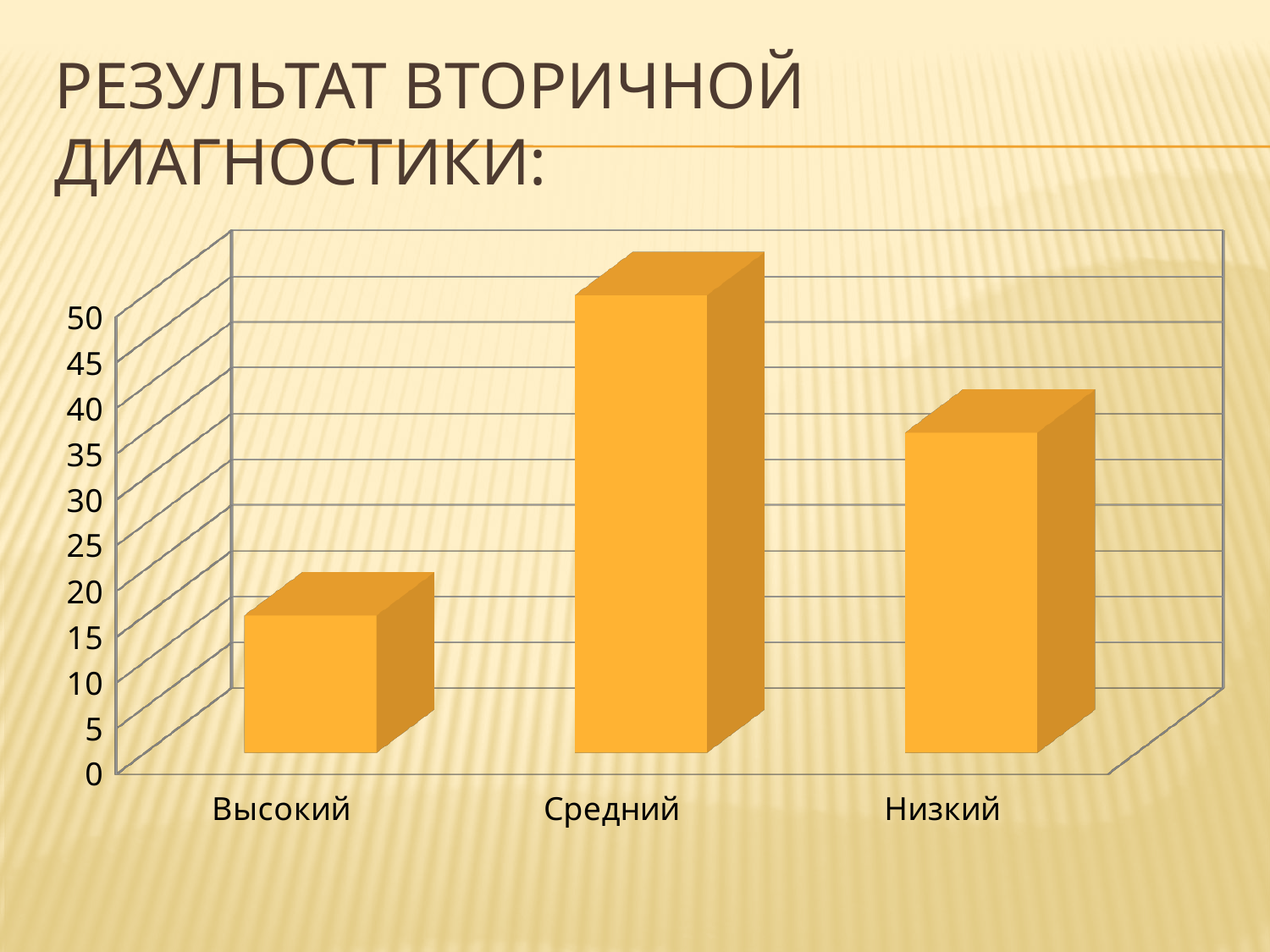
Is the value for Средний greater or less than 40? greater What is the title of the slide containing the chart? Результат вторичной диагностики: Which category has the highest bar in the chart? Средний What kind of chart is shown on the slide? Bar chart How many categories are shown on the x axis of the chart? 3 Is the value for Высокий greater or less than 30? less Is the value for Низкий greater or less than 50? less Which category has the lowest bar in the chart? Высокий Which is larger, the value for Средний or the value for Низкий? Средний What is the highest value shown on the vertical axis of the chart? 50 Which is larger, the value for Высокий or the value for Низкий? Низкий